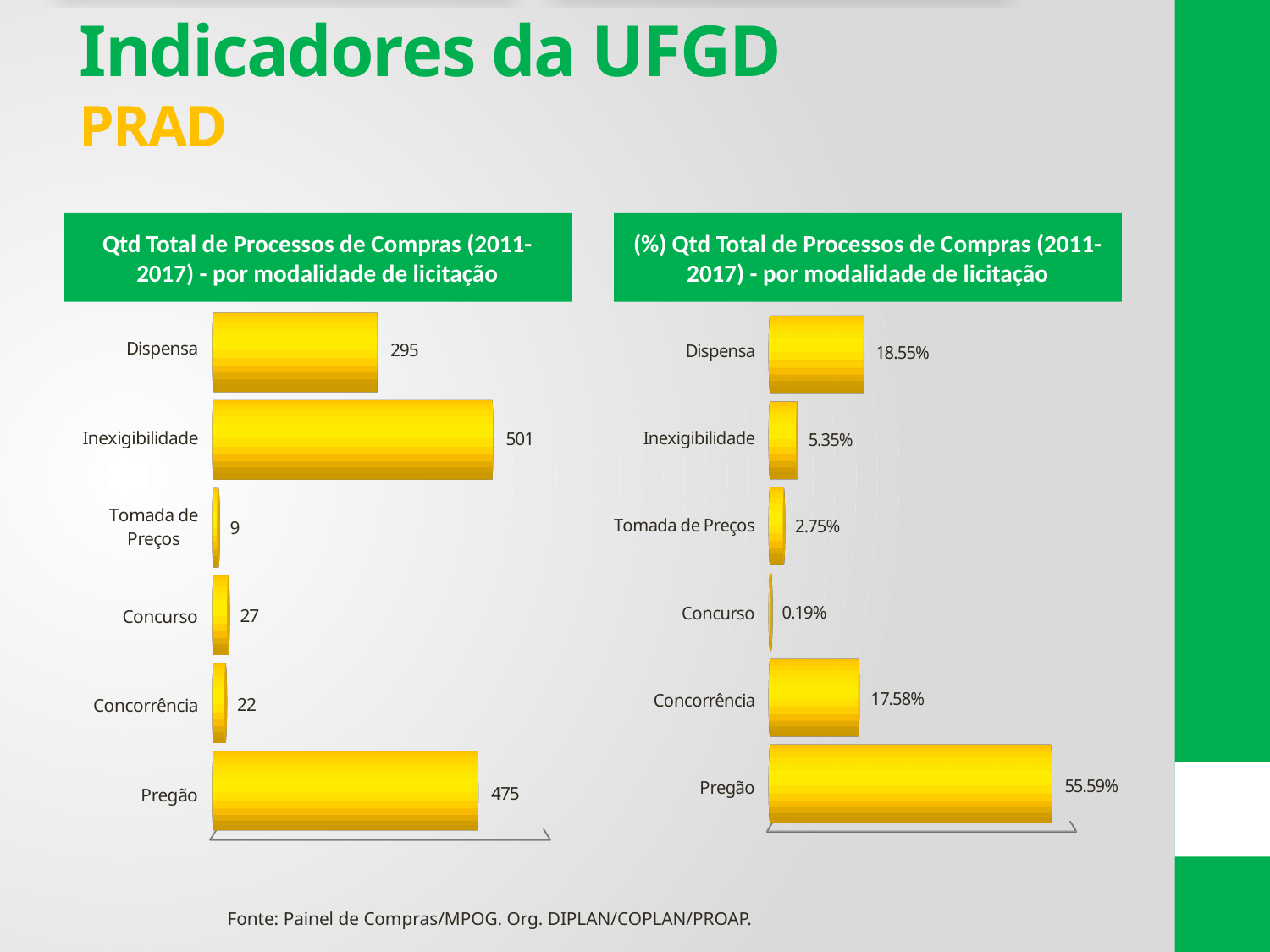
In the left chart (Qtd Total de Processos de Compras), which is larger, Concurso or Concorrência? Concurso In the left chart (Qtd Total de Processos de Compras), what is the difference between the values for Pregão and Dispensa? 180 In the right chart ((%) Qtd Total de Processos de Compras), what is the value for Pregão? 55.59% In the right chart ((%) Qtd Total de Processos de Compras), which is larger, Dispensa or Concorrência? Dispensa In the left chart (Qtd Total de Processos de Compras), which category has the lowest value? Tomada de Preços In the right chart ((%) Qtd Total de Processos de Compras), what is the value for Concurso? 0.19% In the left chart (Qtd Total de Processos de Compras), what is the value for Tomada de Preços? 9 In the left chart (Qtd Total de Processos de Compras), which category has the highest value? Inexigibilidade How many categories are shown in the left chart (Qtd Total de Processos de Compras)? 6 In the left chart (Qtd Total de Processos de Compras), what is the value for Inexigibilidade? 501 What type of chart is the left chart (Qtd Total de Processos de Compras)? Bar chart In the right chart ((%) Qtd Total de Processos de Compras), which category has the lowest value? Concurso